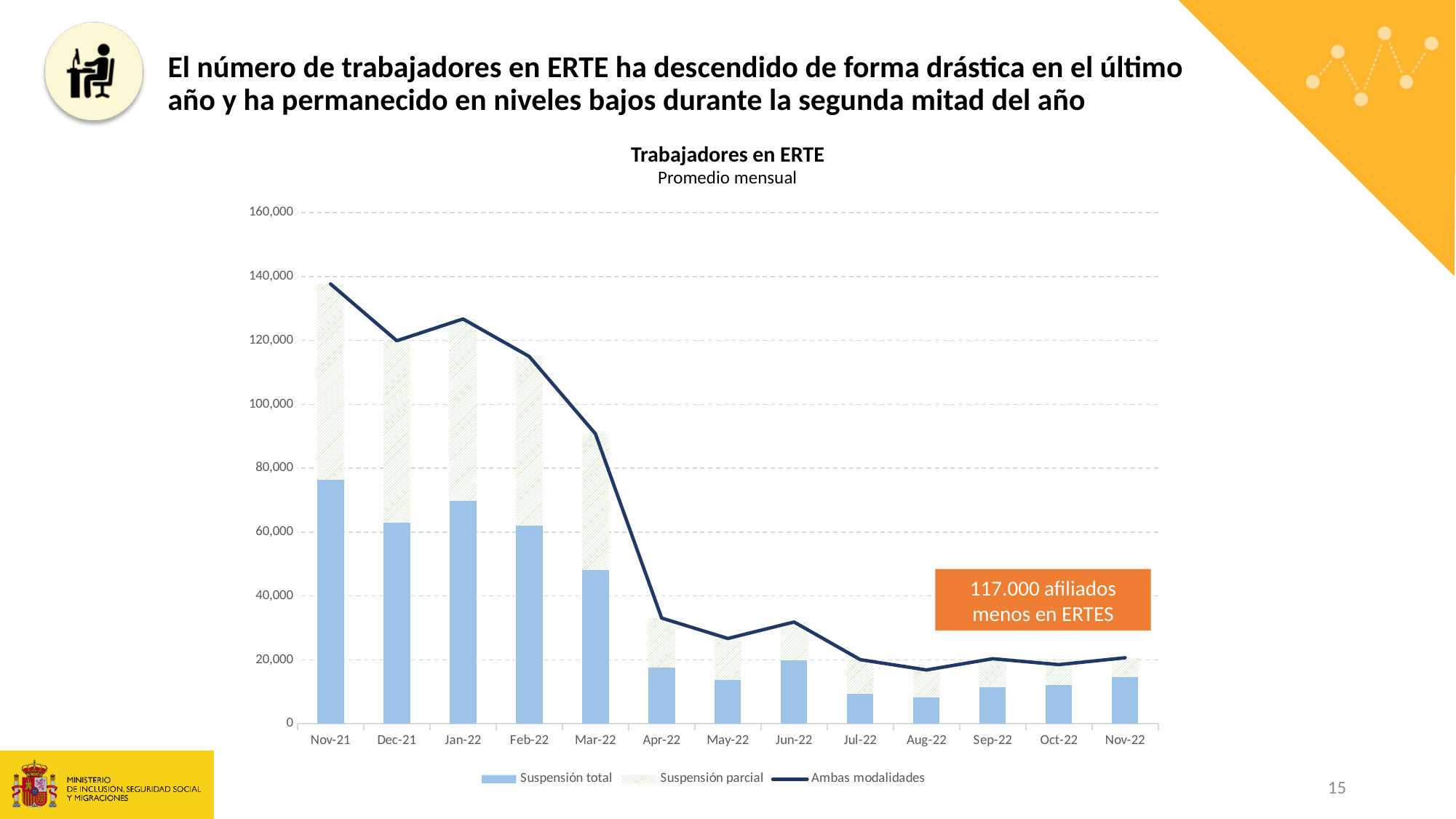
Which is larger, the 'Suspensión total' bar for Dec-21 or for Jan-22? Jan-22 How many months are shown on the x axis of the chart? 13 Does the 'Ambas modalidades' line generally rise or fall from Nov-21 to Nov-22? Fall Is the 'Suspensión total' value for Nov-21 greater or less than 60,000? greater Which month has the highest value for the 'Ambas modalidades' line? Nov-21 Is the 'Ambas modalidades' value for Apr-22 greater or less than 40,000? less How many series does the chart legend list? 3 What kind of chart is shown on the slide? A combined bar and line chart Which month has the tallest 'Suspensión total' bar? Nov-21 Which month has the lowest value for the 'Ambas modalidades' line? Aug-22 What is the subtitle shown under the chart title 'Trabajadores en ERTE'? Promedio mensual Is the 'Ambas modalidades' value for Mar-22 greater or less than 80,000? greater